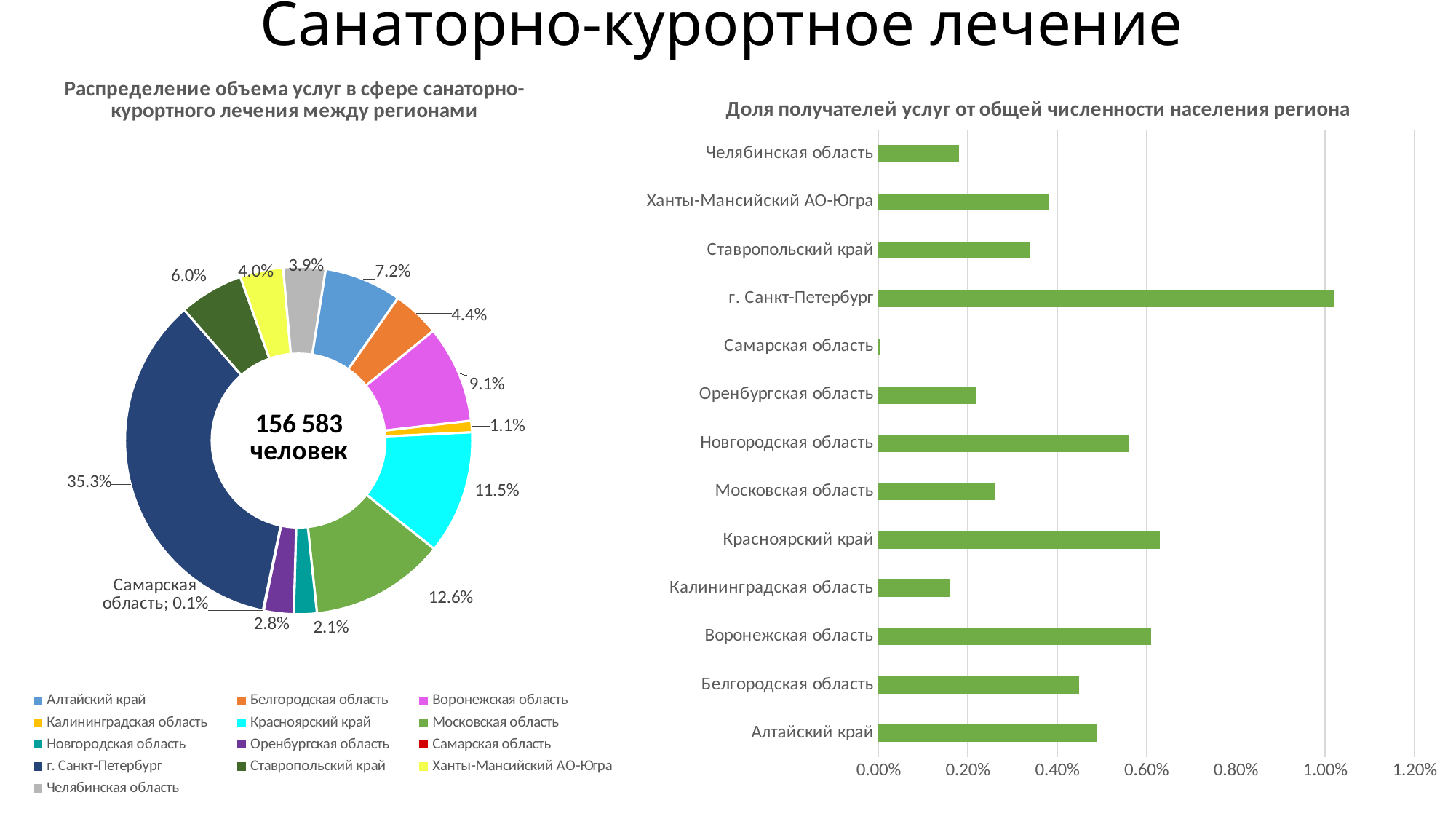
What type of chart is the right chart titled «Доля получателей услуг от общей численности населения региона»? Bar chart In the left doughnut chart, what share does г. Санкт-Петербург have? 35.3% In the left doughnut chart, what share does Самарская область have? 0.1% In the right bar chart, is the value for Новгородская область greater or less than 0.40%? greater What type of chart is the left chart titled «Распределение объема услуг в сфере санаторно-курортного лечения между регионами»? Doughnut (pie) chart What total number of people is shown in the centre of the left doughnut chart? 156 583 человек In the right bar chart, which region has the highest share of service recipients? г. Санкт-Петербург In the right bar chart, which region has the lowest share of service recipients? Самарская область In the left doughnut chart, what is the difference between the shares of Красноярский край and Воронежская область? 2.4% In the left doughnut chart, what share does Московская область have? 12.6% How many regions does the legend of the left doughnut chart list? 13 In the left doughnut chart, which region has the largest share? г. Санкт-Петербург